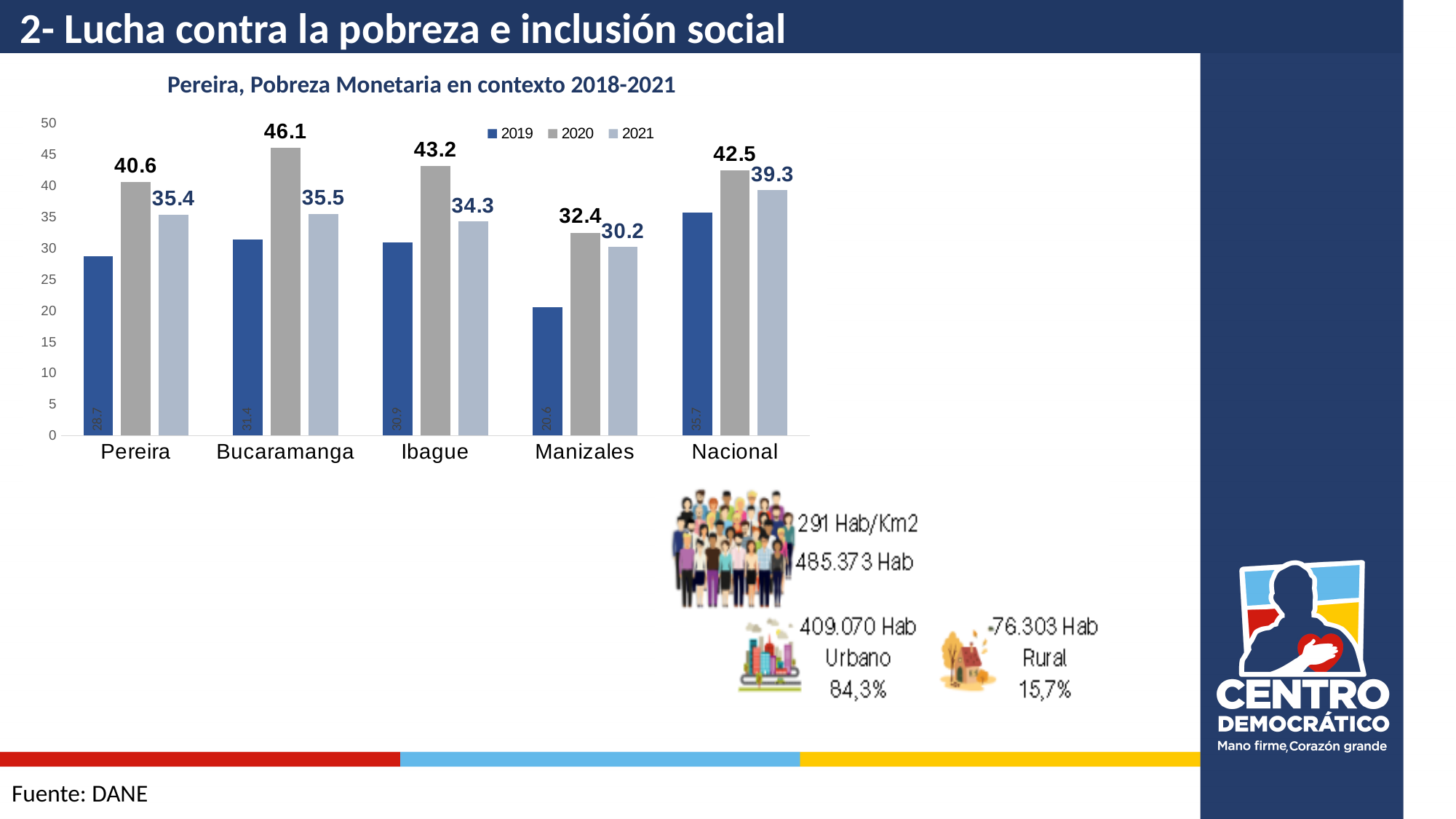
How many categories are shown on the x axis? 5 Is the 2019 value for Pereira greater or less than 30? less What is the 2019 value for Manizales? 20.6 What is the 2021 value for Nacional? 39.3 What kind of chart is shown on the slide? bar chart Which category has the highest 2020 value? Bucaramanga Which category has the lowest 2021 value? Manizales What is the difference between the 2020 and 2021 values for Pereira? 5.2 How many series does the legend list? 3 What is the title of the chart? Pereira, Pobreza Monetaria en contexto 2018-2021 What is the 2020 value for Bucaramanga? 46.1 Which is larger, the 2021 value for Ibague or the 2021 value for Nacional? Nacional